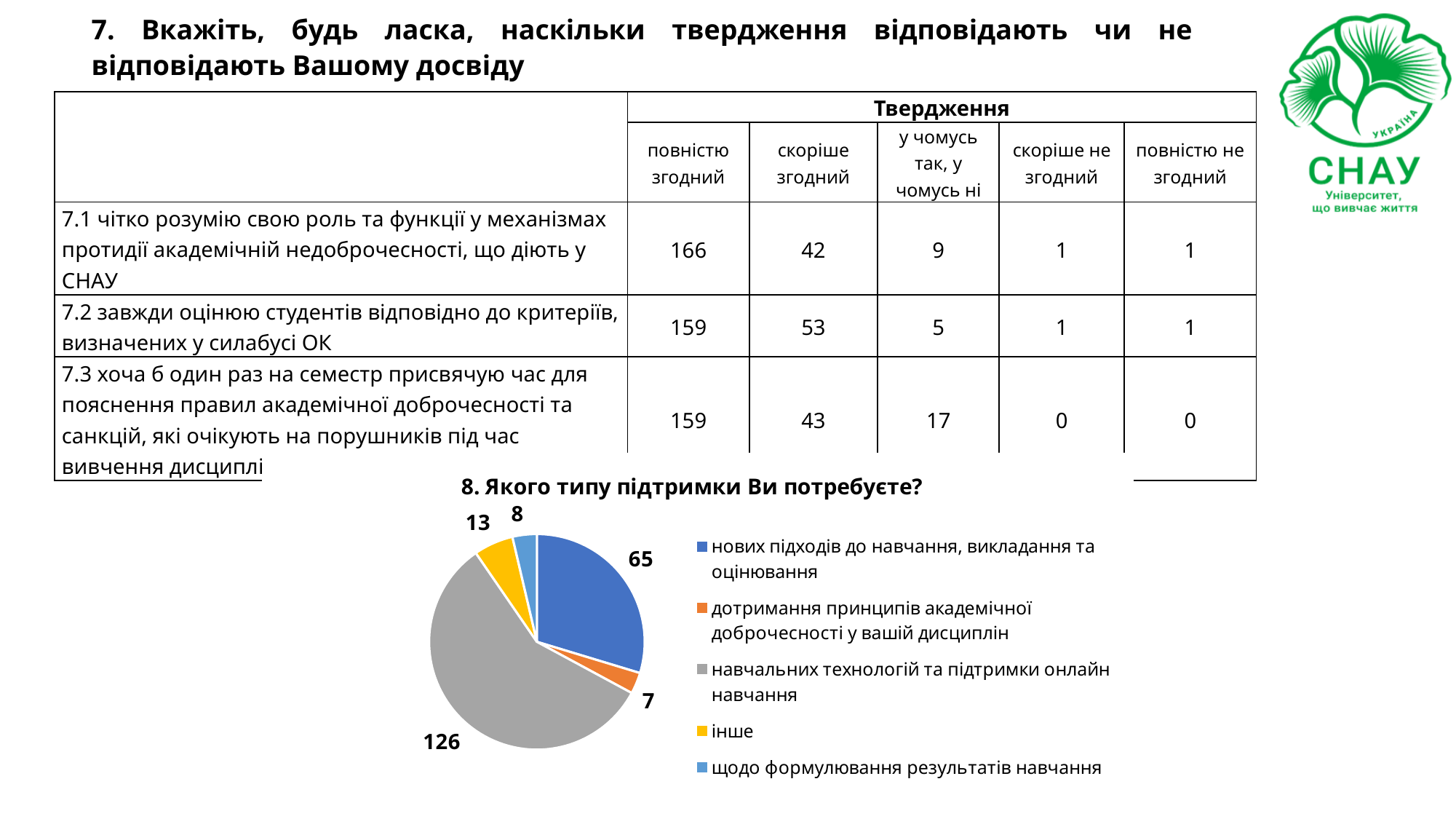
Which category has the largest slice in the pie chart? навчальних технологій та підтримки онлайн навчання Which is larger in the pie chart: 'інше' or 'щодо формулювання результатів навчання'? інше Which category has the smallest slice in the pie chart? дотримання принципів академічної доброчесності у вашій дисциплін What is the title of the pie chart? 8. Якого типу підтримки Ви потребуєте? What is the value for 'дотримання принципів академічної доброчесності у вашій дисциплін' in the pie chart? 7 What is the value for 'інше' in the pie chart? 13 What is the value for 'нових підходів до навчання, викладання та оцінювання' in the pie chart? 65 What is the difference between the values for 'навчальних технологій та підтримки онлайн навчання' and 'нових підходів до навчання, викладання та оцінювання'? 61 What is the value for 'навчальних технологій та підтримки онлайн навчання' in the pie chart? 126 What type of chart is shown on the slide? pie chart What is the value for 'щодо формулювання результатів навчання' in the pie chart? 8 How many categories does the legend of the pie chart list? 5